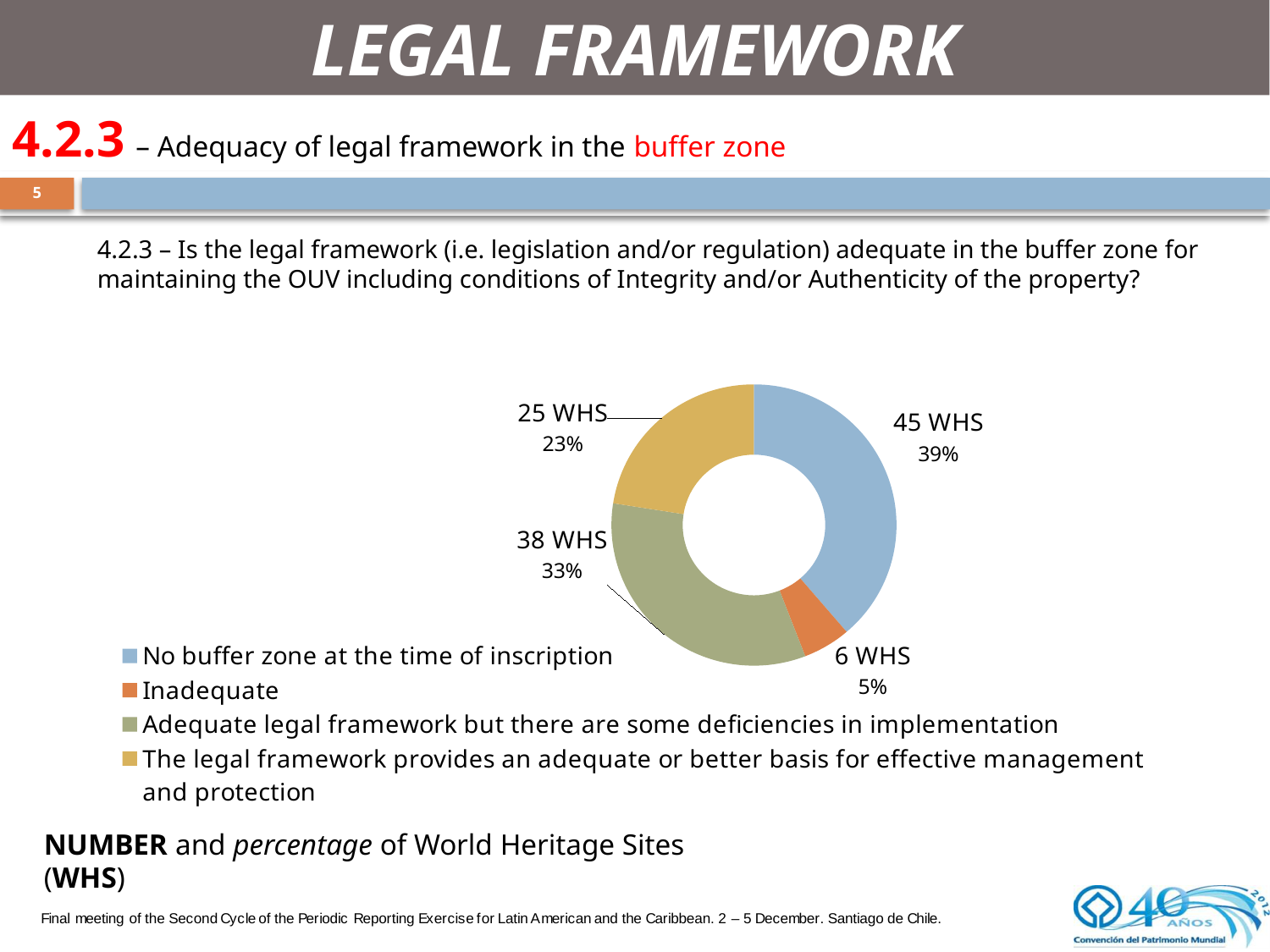
Which colour represents the 'Inadequate' category in the chart? Orange What percentage of World Heritage Sites reported an inadequate legal framework in the buffer zone? 5% How many more World Heritage Sites had no buffer zone at the time of inscription than reported an adequate legal framework with some deficiencies in implementation? 7 What kind of chart is shown on the slide? Doughnut chart Which category has the smallest share of World Heritage Sites? Inadequate Which category has the largest share of World Heritage Sites? No buffer zone at the time of inscription What percentage of World Heritage Sites reported that the legal framework provides an adequate or better basis for effective management and protection? 23% How many World Heritage Sites reported an adequate legal framework but with some deficiencies in implementation? 38 WHS How many World Heritage Sites had no buffer zone at the time of inscription? 45 WHS How many categories does the chart show? 4 What is the total number of World Heritage Sites across all four categories in the chart? 114 Which category has more World Heritage Sites: 'Inadequate' or 'The legal framework provides an adequate or better basis for effective management and protection'? The legal framework provides an adequate or better basis for effective management and protection